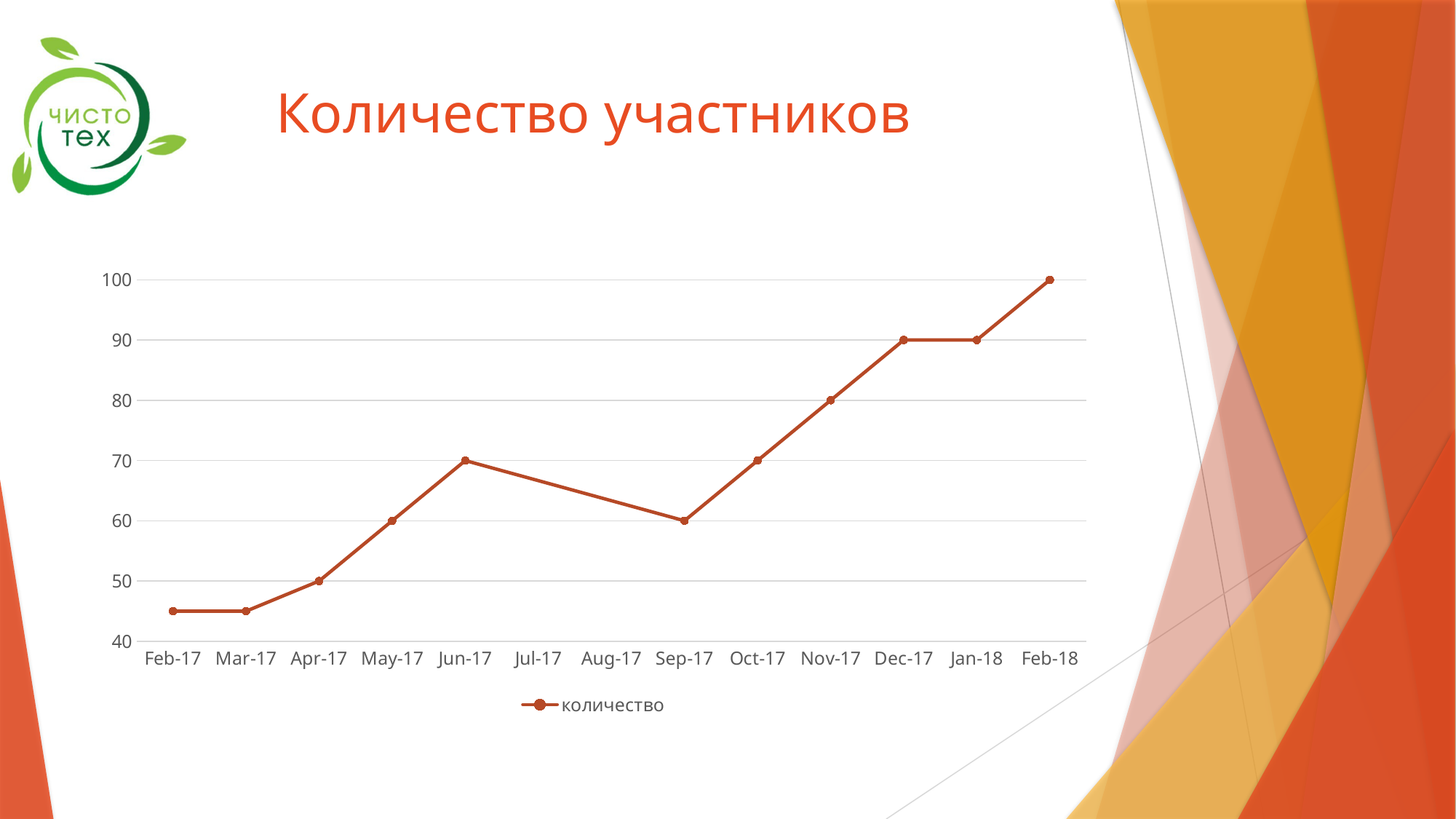
What is the value for Sep-17? 60 What is the value for Jun-17? 70 What is the title of the chart on the slide? Количество участников What is the difference between the values for Feb-18 and Jun-17? 30 What is the value for Feb-18? 100 Which is larger, the value for Jun-17 or the value for Sep-17? Jun-17 What is the value for Nov-17? 80 What kind of chart is shown on the slide? line chart How many data points are plotted on the chart? 11 Which month has the highest value? Feb-18 Is the value for Feb-17 greater or less than 50? less